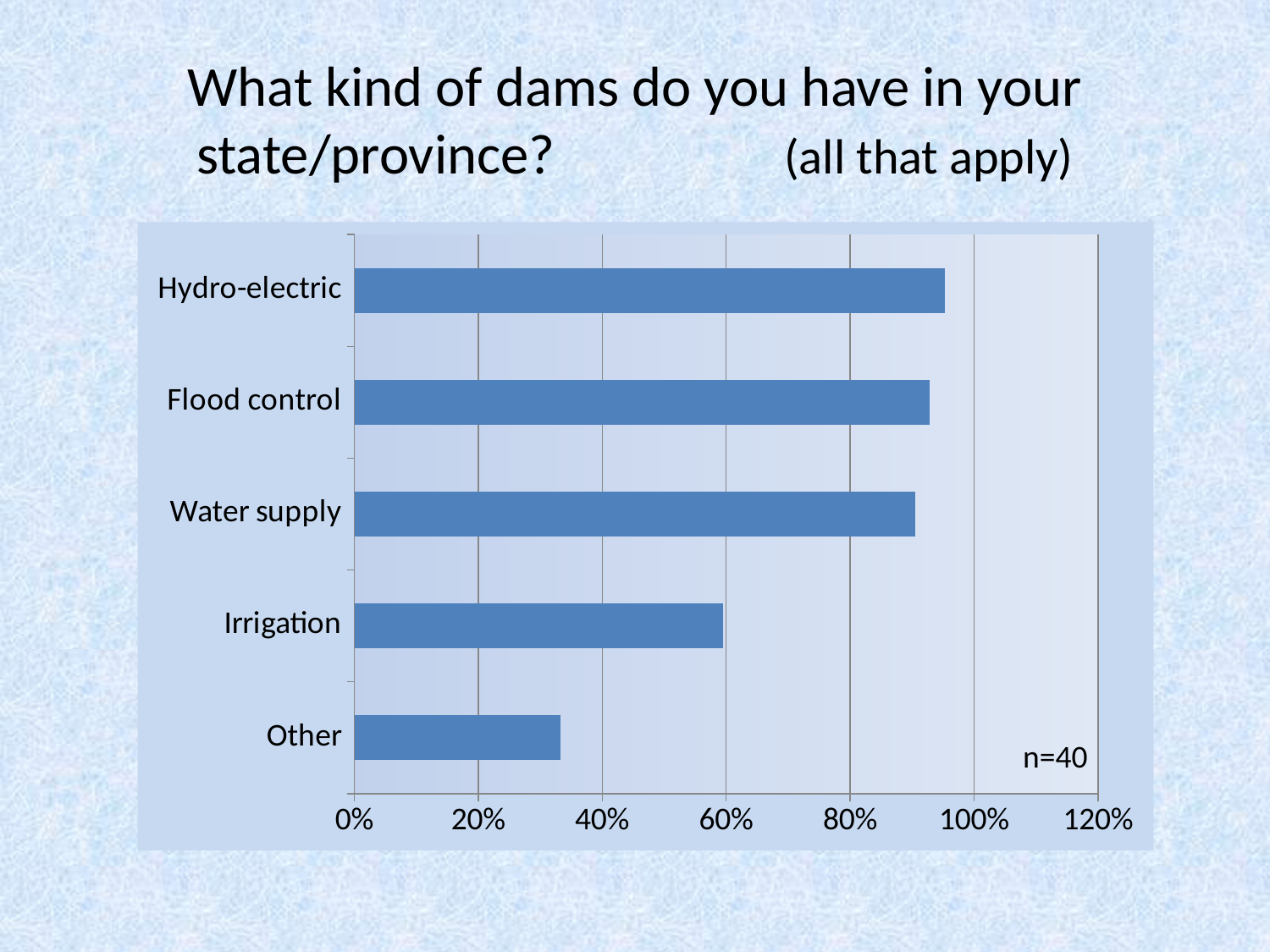
Is the value for Other greater or less than 40%? less Is the value for Water supply greater or less than 80%? greater What sample size (n) is noted on the chart? n=40 Is the value for Irrigation greater or less than 80%? less What kind of chart is shown on the slide? bar chart Which has a larger value, Irrigation or Other? Irrigation How many categories of dams are shown in the chart? 5 Which has a larger value, Water supply or Irrigation? Water supply Which category has the lowest value in the chart? Other